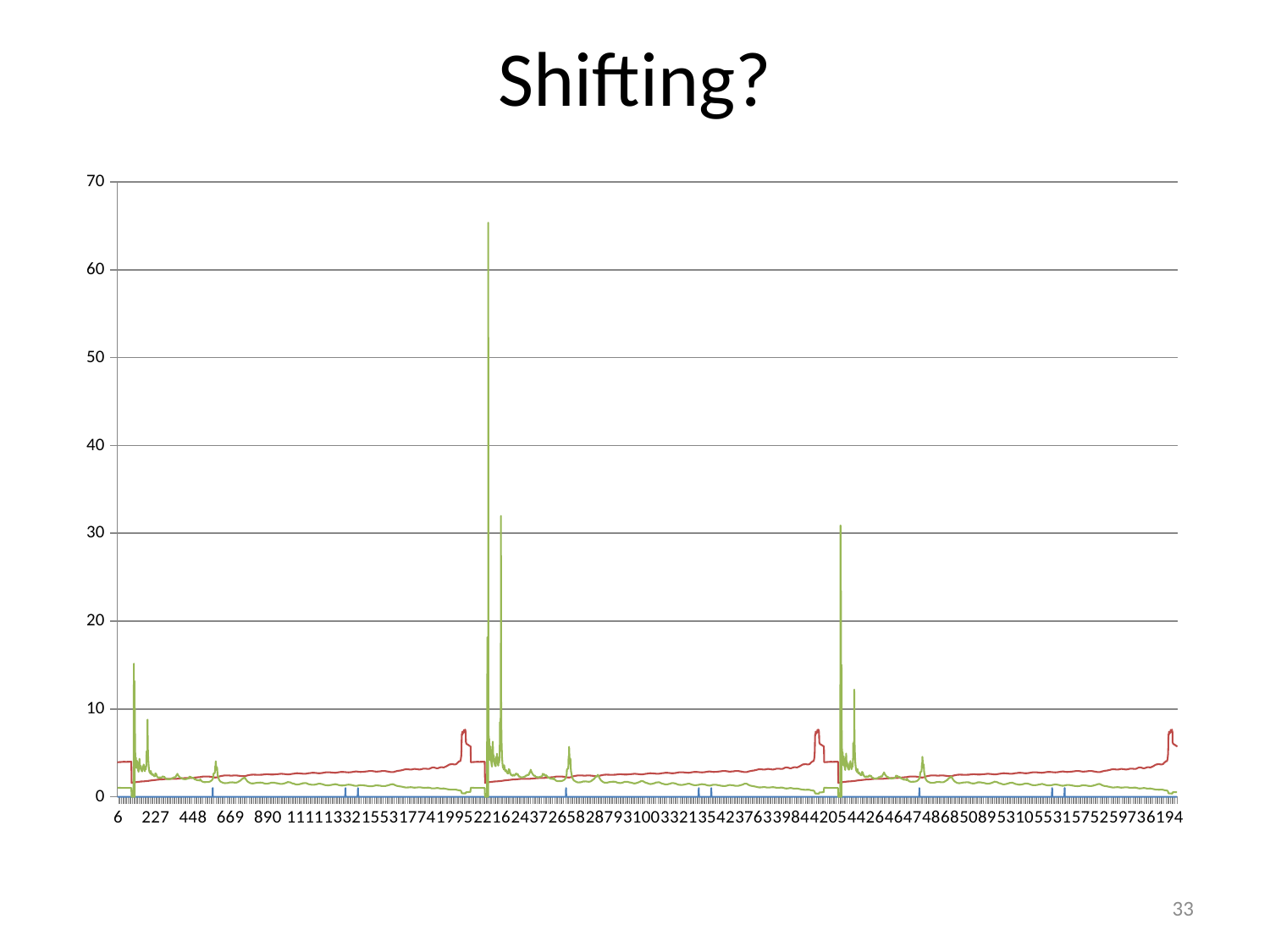
Is the green spike near the x-axis label 227 greater or less than 20? less Which line reaches the highest value on the chart, the green line or the red line? green What is the highest value shown on the vertical axis? 70 Is the highest value reached by the red line greater or less than 10? less Is the highest peak of the green line greater or less than 60? greater What kind of chart is shown on the slide? line chart What is the first label on the horizontal axis? 6